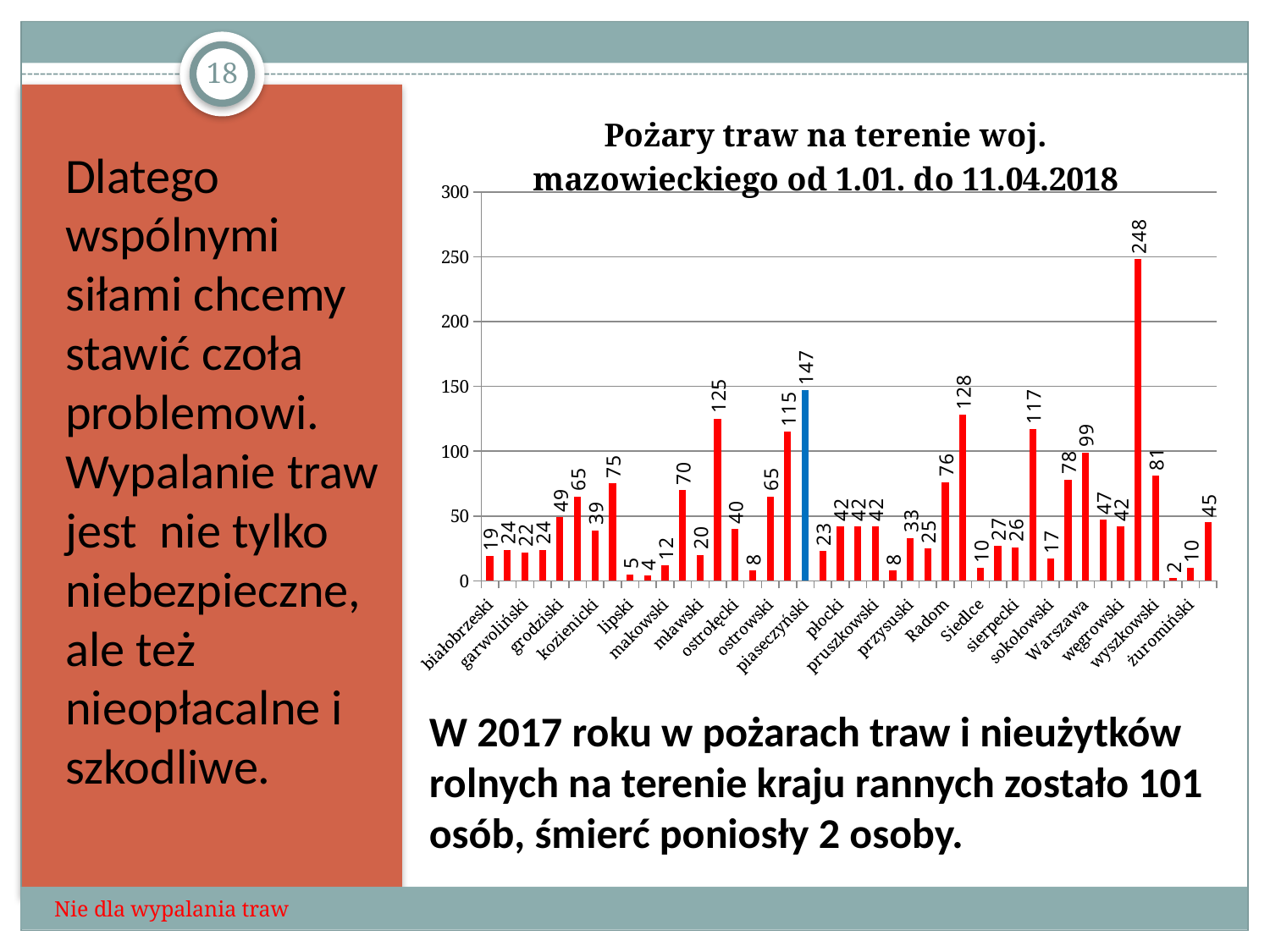
What is the value for białobrzeski? 19 Which category is drawn with a blue bar instead of a red one? piaseczyński What is the title of the chart? Pożary traw na terenie woj. mazowieckiego od 1.01. do 11.04.2018 What is the value for Warszawa? 99 What is the difference between the highest bar (248) and the value for piaseczyński? 101 What is the lowest value shown on the chart? 2 Which has a larger value, Warszawa or Radom? Warszawa What is the highest value shown on the chart? 248 What kind of chart is shown on the slide? bar chart What is the value for piaseczyński? 147 Is the value for piaseczyński greater or less than 100? greater What is the value for Radom? 76